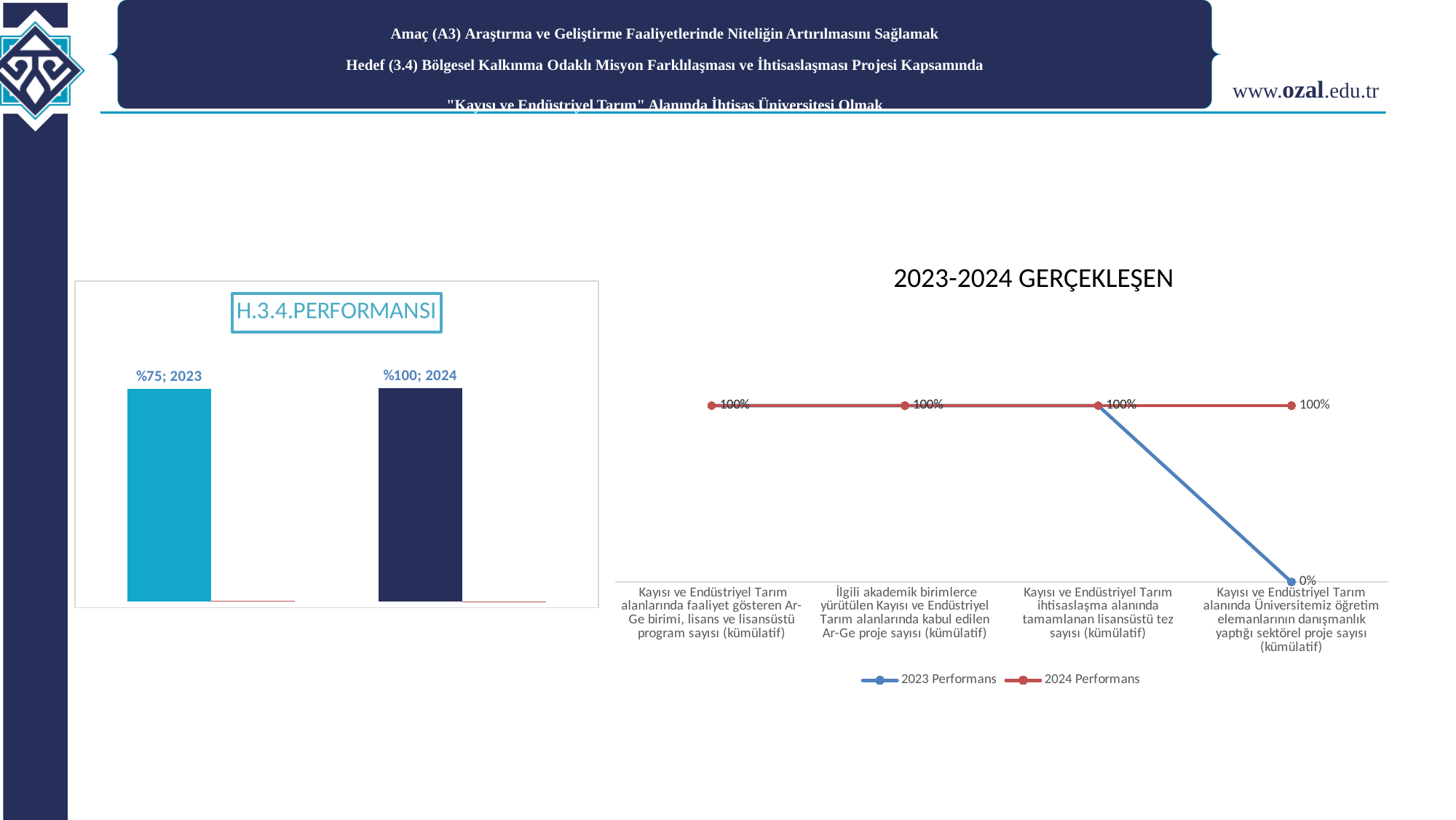
What kind of chart is the 2023-2024 GERÇEKLEŞEN chart? Line chart In the H.3.4.PERFORMANSI chart, what is the value for 2023? %75 In the 2023-2024 GERÇEKLEŞEN chart, which series is drawn in red? 2024 Performans In the H.3.4.PERFORMANSI chart, what is the value for 2024? %100 In the H.3.4.PERFORMANSI chart, which year has the higher value? 2024 What kind of chart is the H.3.4.PERFORMANSI chart? Bar chart In the 2023-2024 GERÇEKLEŞEN chart, what is the 2024 Performans value for the category about tamamlanan lisansüstü tez sayısı (kümülatif)? 100% In the H.3.4.PERFORMANSI chart, what is the difference between the 2024 and 2023 values? %25 How many bars are in the H.3.4.PERFORMANSI chart? 2 In the 2023-2024 GERÇEKLEŞEN chart, what is the 2023 Performans value for the category about sektörel proje sayısı (kümülatif)? 0% How many series does the legend of the 2023-2024 GERÇEKLEŞEN chart list? 2 How many categories are on the x axis of the 2023-2024 GERÇEKLEŞEN chart? 4